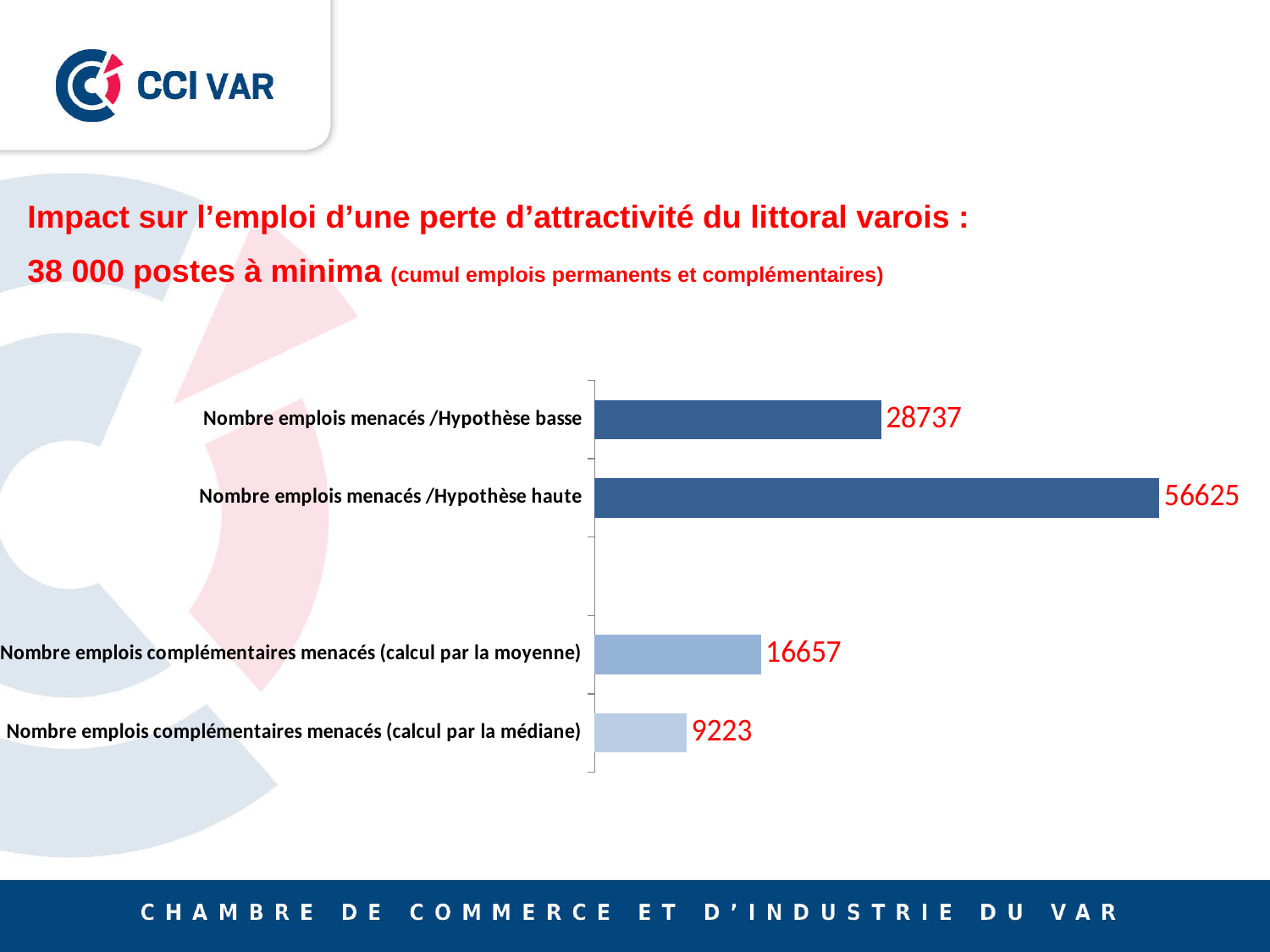
Which category has the highest value? Nombre emplois menacés /Hypothèse haute How many bars are plotted in the chart? 4 What is the value for "Nombre emplois menacés /Hypothèse haute"? 56625 What is the difference between the "Hypothèse haute" and "Hypothèse basse" values? 27888 Which category has the lowest value? Nombre emplois complémentaires menacés (calcul par la médiane) What is the difference between the "calcul par la moyenne" and "calcul par la médiane" values? 7434 What is the value for "Nombre emplois complémentaires menacés (calcul par la moyenne)"? 16657 What kind of chart is shown on the slide? Bar chart What is the value for "Nombre emplois complémentaires menacés (calcul par la médiane)"? 9223 What colour are the data labels next to the bars? Red What is the value for "Nombre emplois menacés /Hypothèse basse"? 28737 Which is larger: the value for "Hypothèse basse" or the value for "calcul par la moyenne"? Hypothèse basse